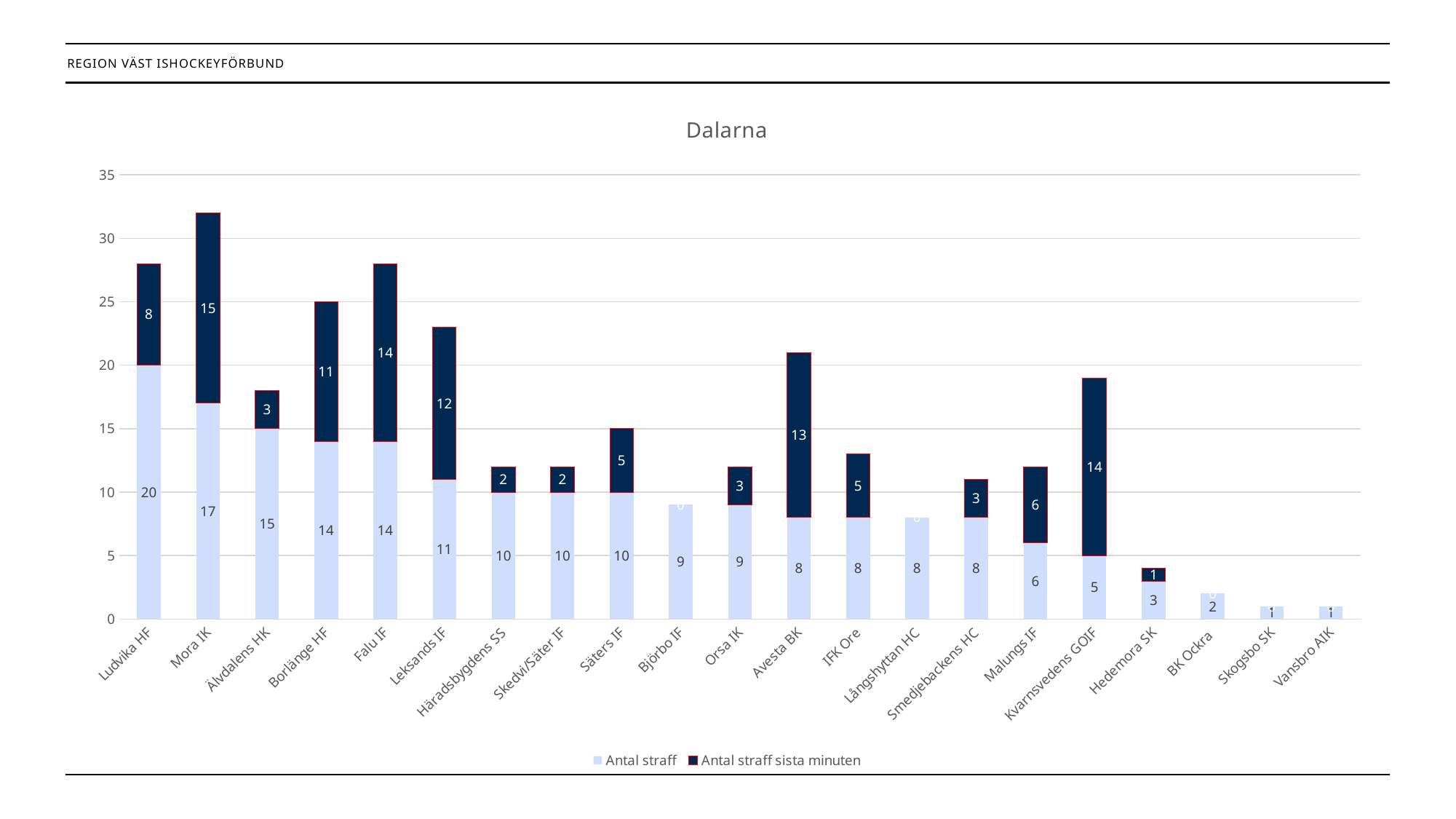
How many teams (categories) are shown on the x axis? 21 How many series does the legend list? 2 Which is larger: 'Antal straff sista minuten' for Borlänge HF or for Leksands IF? Leksands IF What is the value of 'Antal straff' for Ludvika HF? 20 What is the difference between 'Antal straff' for Ludvika HF and 'Antal straff' for Mora IK? 3 What is the value of 'Antal straff sista minuten' for Mora IK? 15 Which team has the highest value for 'Antal straff'? Ludvika HF What is the title of the chart? Dalarna What type of chart is shown on the slide? Stacked bar chart What is the total of the stacked bar for Avesta BK? 21 What is the total of the stacked bar for Mora IK? 32 What is the value of 'Antal straff sista minuten' for Kvarnsvedens GoIF? 14